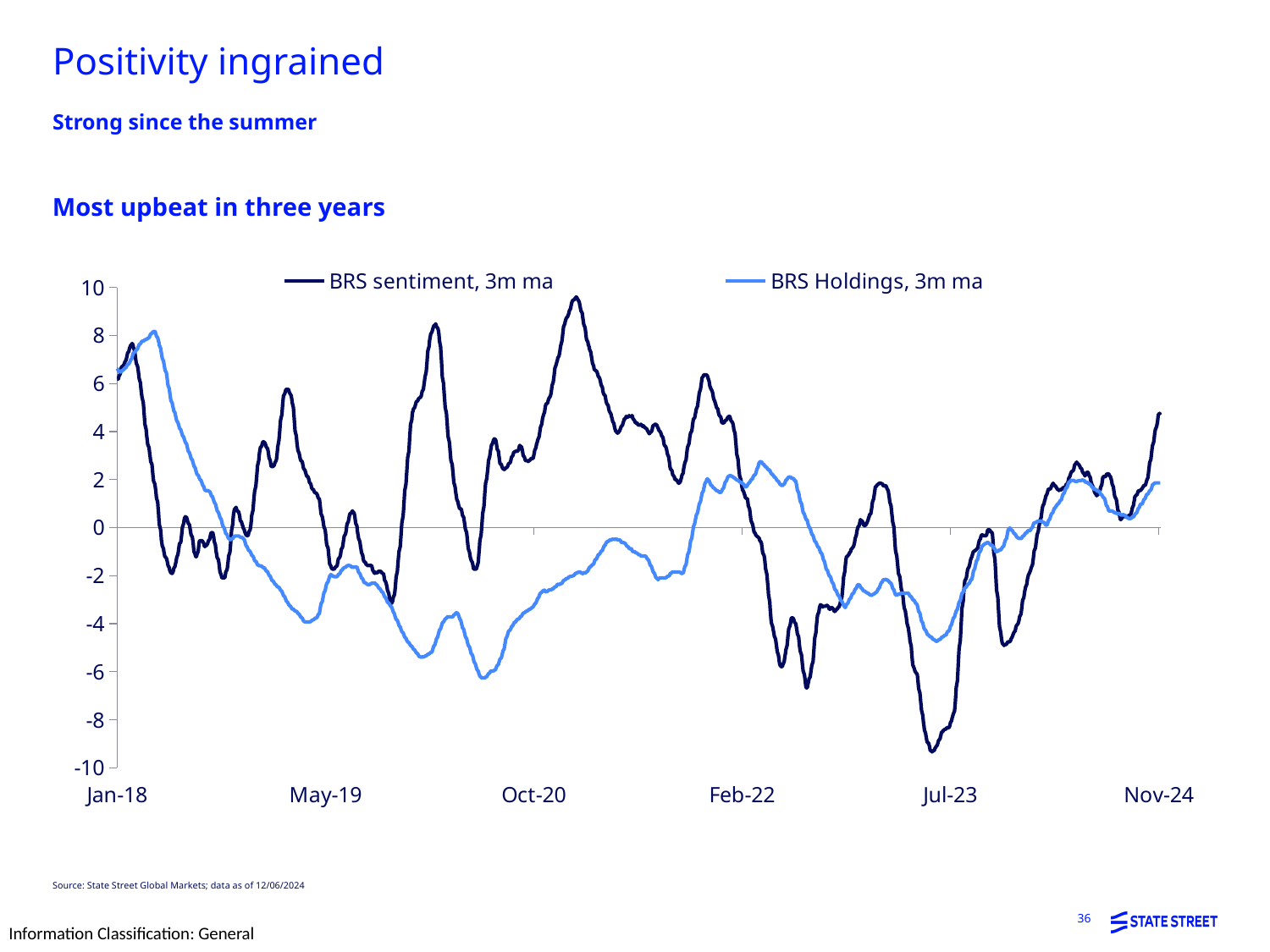
Is the lowest value reached by BRS sentiment, 3m ma (around mid-2023) greater or less than -8? less What kind of chart is shown on the slide? line chart Is the value of BRS Holdings, 3m ma at Jan-18 greater or less than 4? greater Does BRS sentiment, 3m ma rise or fall between Jul-23 and Nov-24? rise At Nov-24, which series has the higher value, BRS sentiment, 3m ma or BRS Holdings, 3m ma? BRS sentiment, 3m ma At Jul-23, which series has the higher value, BRS sentiment, 3m ma or BRS Holdings, 3m ma? BRS Holdings, 3m ma Is the value of BRS sentiment, 3m ma at Nov-24 greater or less than 2? greater Which series is drawn in the lighter blue line? BRS Holdings, 3m ma How many date labels are shown on the x axis? 6 How many series does the chart legend list? 2 What are the two series named in the chart legend? BRS sentiment, 3m ma and BRS Holdings, 3m ma